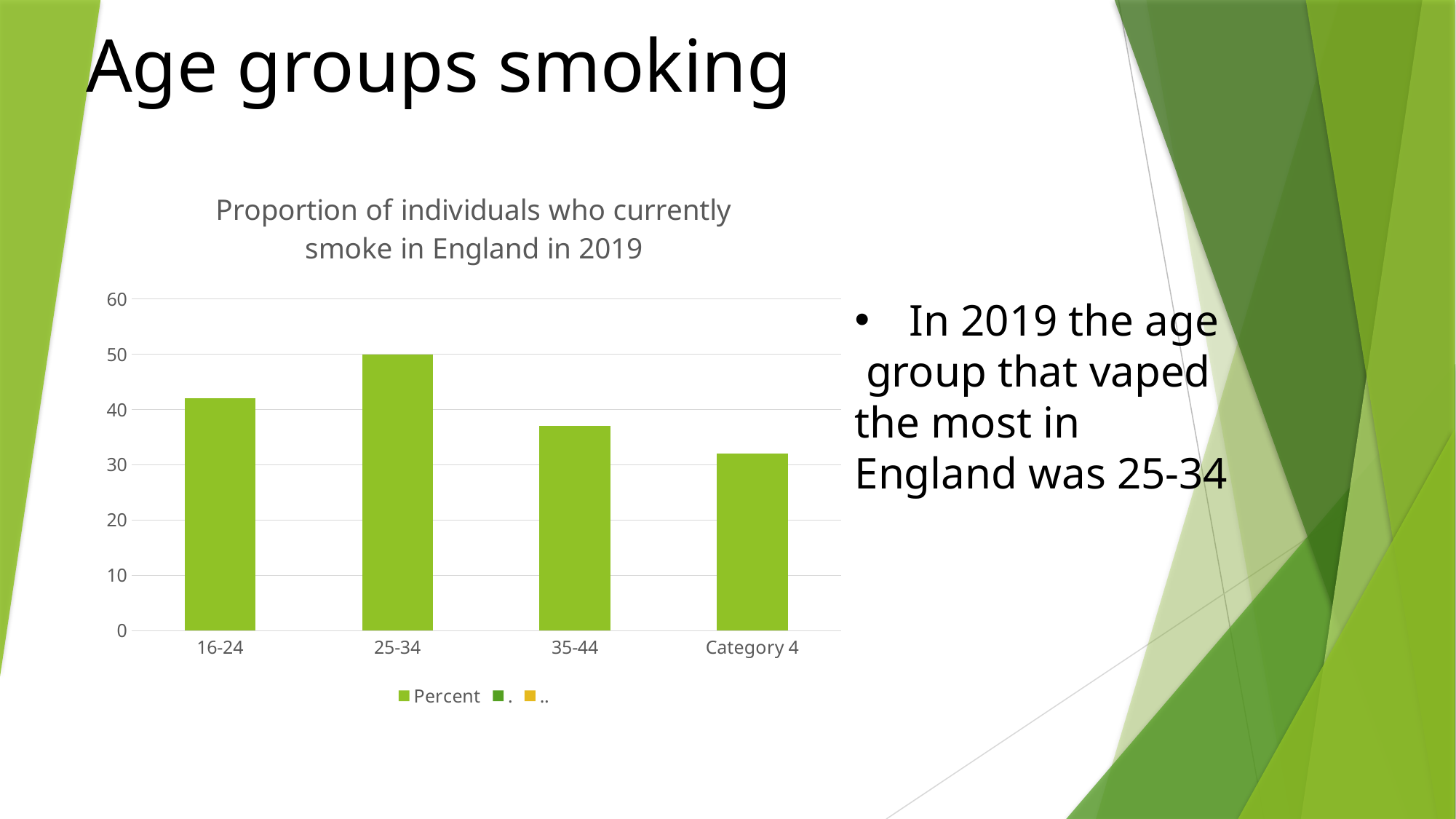
Is the value for Category 4 greater or less than 30? greater Which is larger, the value for 16-24 or the value for 35-44? 16-24 How many categories are shown on the x axis of the chart? 4 Which category has the lowest bar in the chart? Category 4 Do the values rise or fall from 25-34 to Category 4 along the x axis? fall Is the value for 35-44 greater or less than 40? less Is the value for 16-24 greater or less than 40? greater What kind of chart is shown on the slide? bar chart What is the title of the chart? Proportion of individuals who currently smoke in England in 2019 Which age group has the highest bar in the chart? 25-34 How many entries does the chart's legend list? 3 What is the value for the 25-34 age group? 50